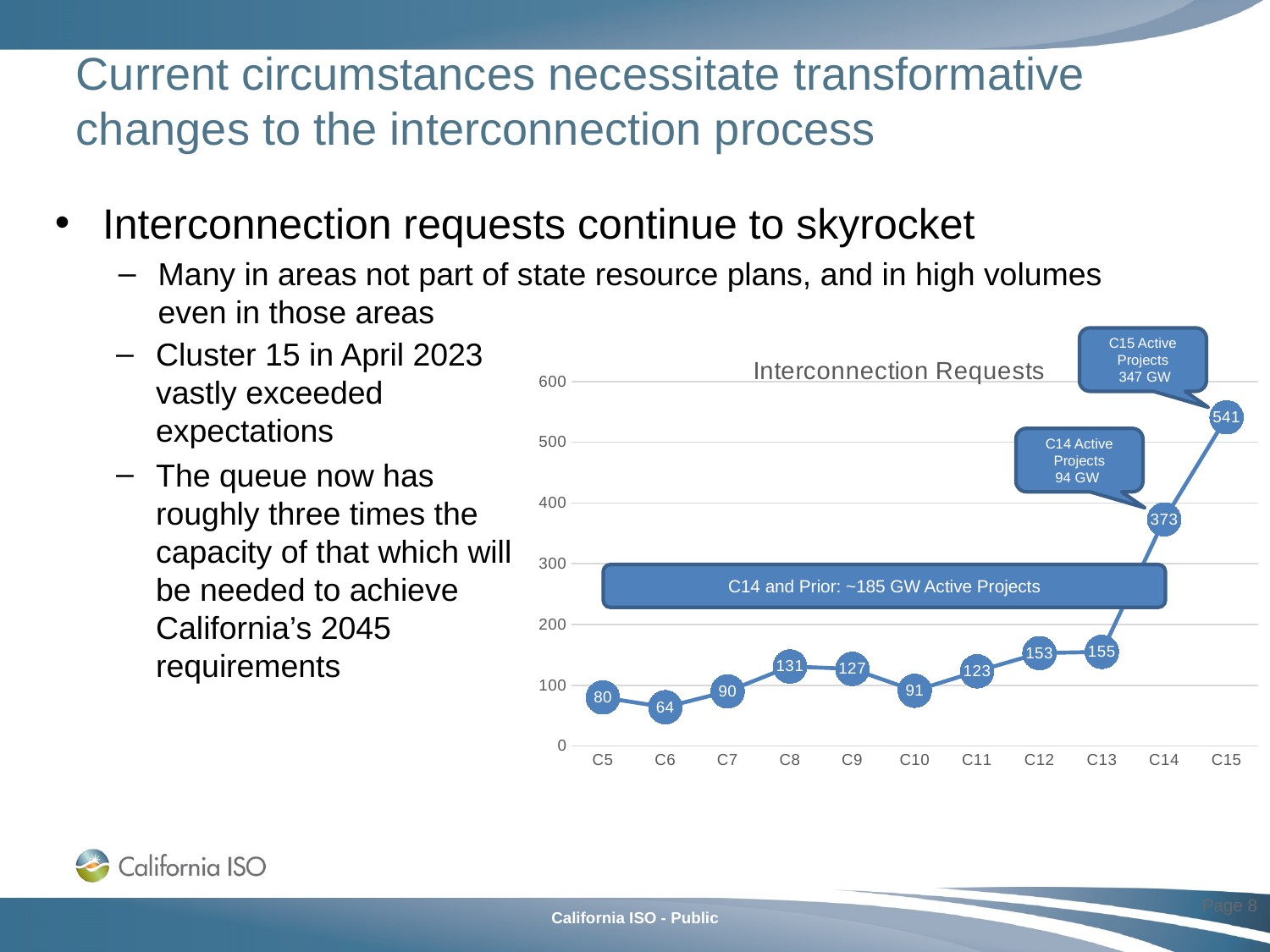
Which category has the highest value in the Interconnection Requests chart? C15 What is the difference between the values for C15 and C14 in the Interconnection Requests chart? 168 What is the value for C14 in the Interconnection Requests chart? 373 How many categories are shown on the x axis of the Interconnection Requests chart? 11 Which is larger in the Interconnection Requests chart, the value for C8 or the value for C9? C8 Which category has the lowest value in the Interconnection Requests chart? C6 What is the value for C15 in the Interconnection Requests chart? 541 Is the value for C14 in the Interconnection Requests chart greater or less than 300? greater In the Interconnection Requests chart, do the values generally rise or fall from C5 to C15? rise What kind of chart is the Interconnection Requests chart? line chart What is the title of the chart on the slide? Interconnection Requests What is the value for C6 in the Interconnection Requests chart? 64